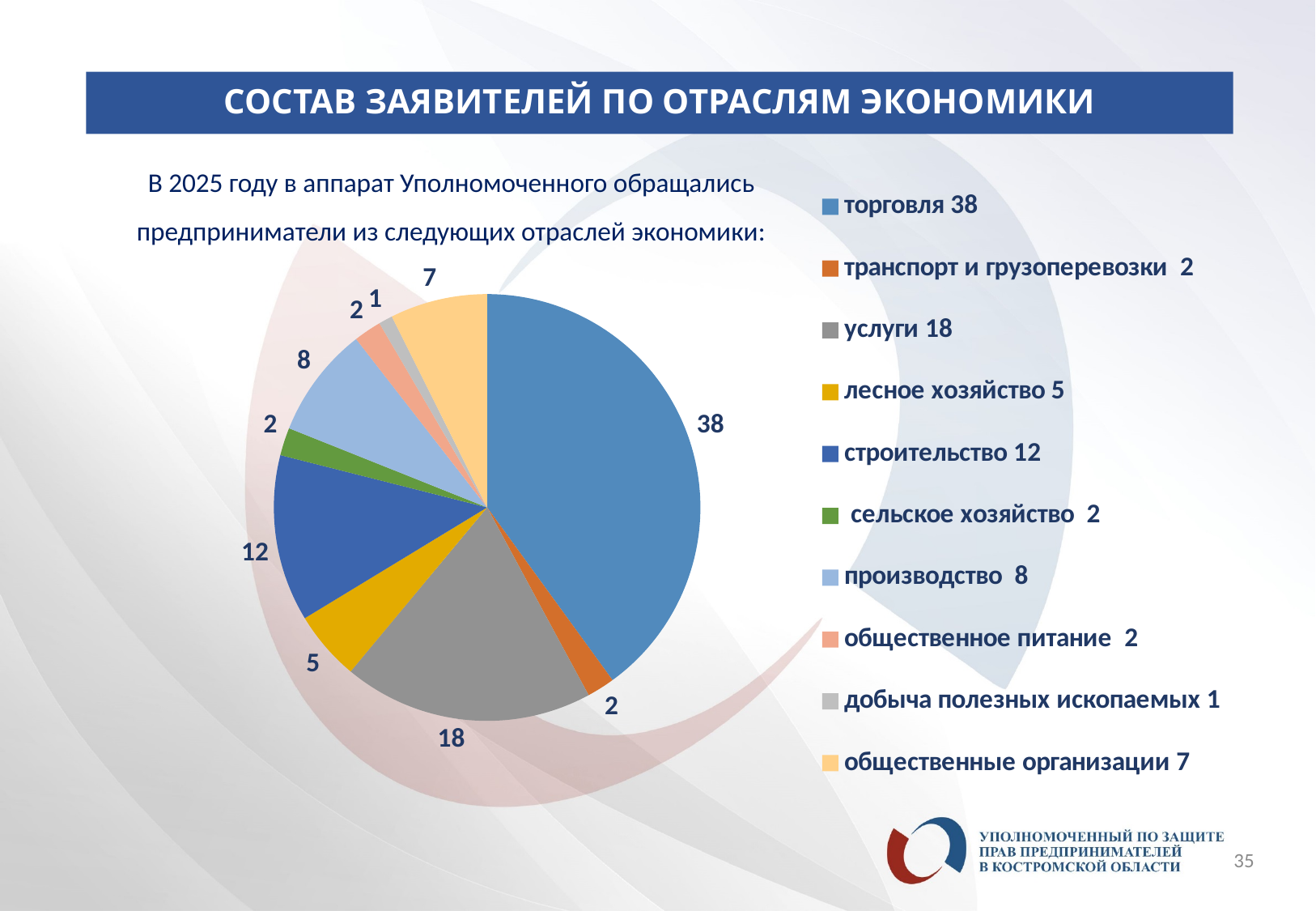
What is the value for строительство? 12 Which category has the largest slice of the pie? торговля Which is larger, производство or лесное хозяйство? производство What share of the pie does торговля represent? 40% What is the value for общественные организации? 7 How many categories does the pie chart have? 10 What is the value for услуги? 18 Which category has the smallest slice of the pie? добыча полезных ископаемых What colour is the slice for сельское хозяйство? green What is the value for торговля? 38 What kind of chart is shown on the slide? pie chart What is the difference between the values for торговля and услуги? 20